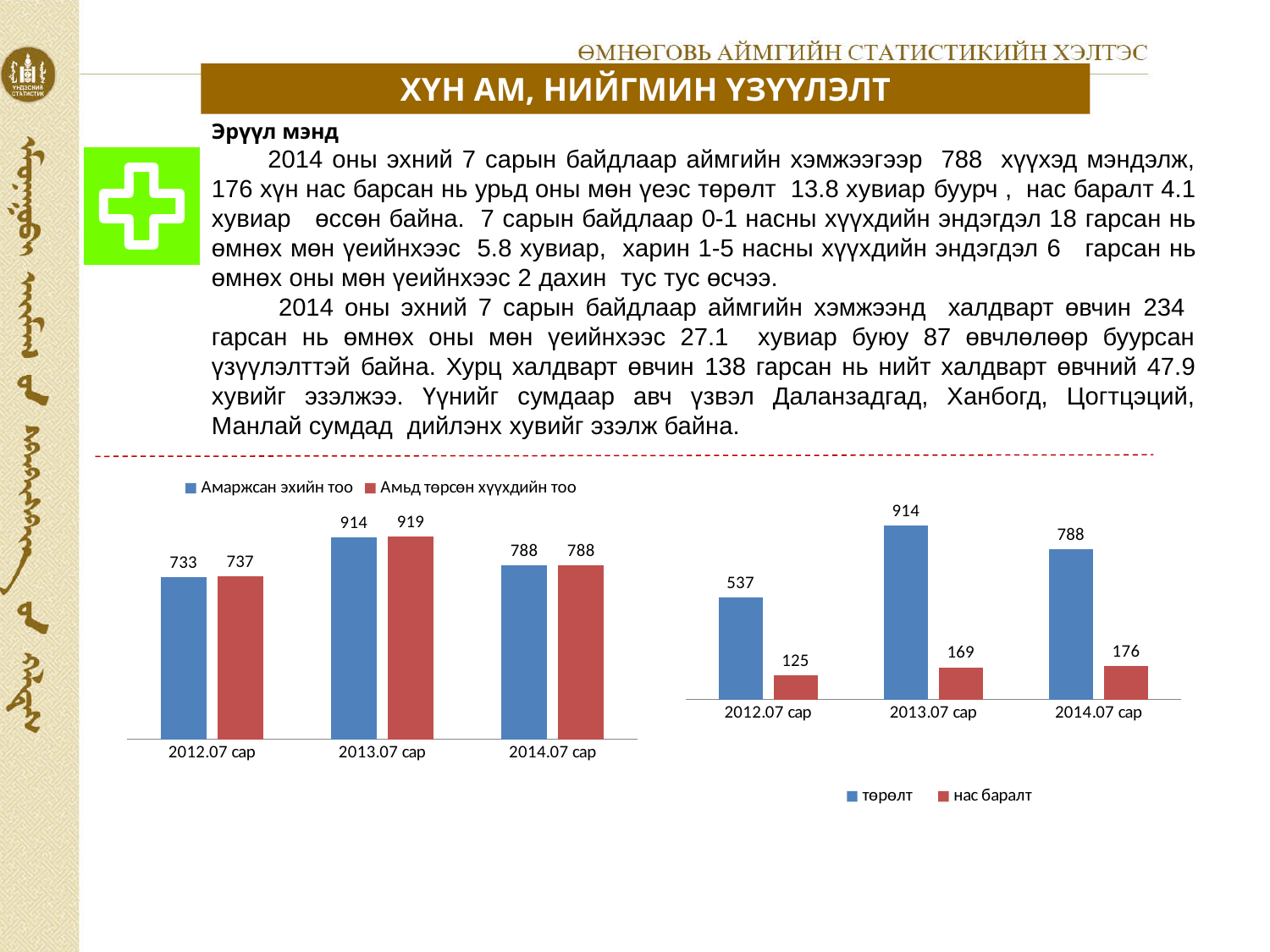
In the right chart, what is the value of нас баралт for 2014.07 сар? 176 In the right chart, does нас баралт rise or fall from 2012.07 сар to 2014.07 сар? Rise In the left chart, how many series does the legend list? 2 In the right chart, what is the difference between төрөлт and нас баралт for 2013.07 сар? 745 In the left chart, what is the value of Амаржсан эхийн тоо for 2013.07 сар? 914 In the left chart, what is the difference between Амьд төрсөн хүүхдийн тоо and Амаржсан эхийн тоо for 2013.07 сар? 5 In the right chart, how many categories are shown on the x axis? 3 In the left chart, which category has the highest value for Амьд төрсөн хүүхдийн тоо? 2013.07 сар In the right chart, which category has the lowest value for нас баралт? 2012.07 сар In the right chart, what is the value of төрөлт for 2012.07 сар? 537 In the left chart, what is the value of Амьд төрсөн хүүхдийн тоо for 2012.07 сар? 737 What kind of chart is the left chart? Bar chart